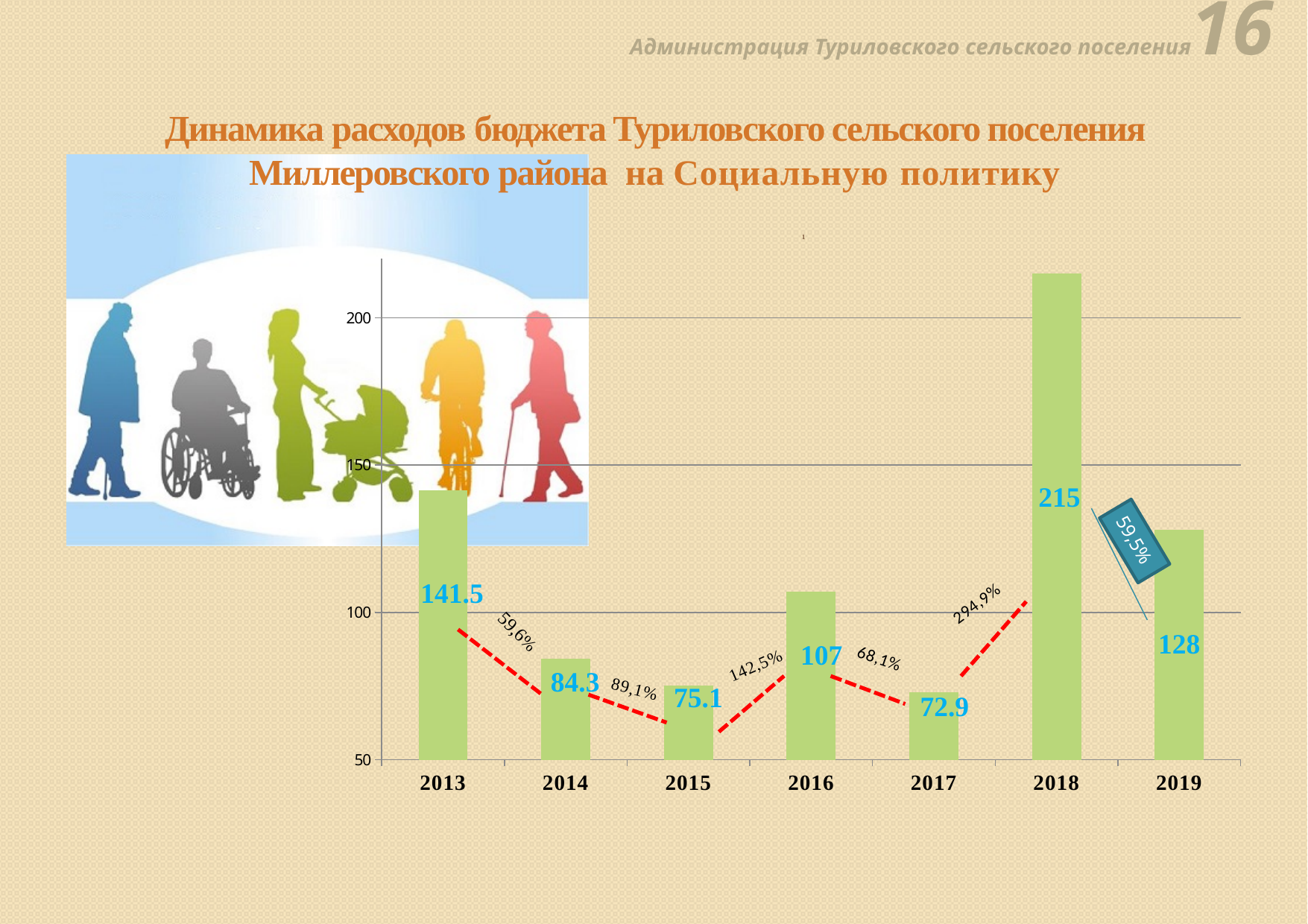
What kind of chart is shown on the slide? bar chart Is the value for 2018 greater or less than 200? greater What is the value for 2017? 72.9 What is the value for 2019? 128 What is the difference between the values for 2018 and 2019? 87 How many years are shown on the x axis? 7 Which year has the lowest value? 2017 What percentage label is shown between the 2017 and 2018 bars? 294,9% Which year has the highest value? 2018 Which is larger, the value for 2016 or the value for 2019? 2019 What is the difference between the values for 2013 and 2014? 57.2 What is the value for 2013? 141.5